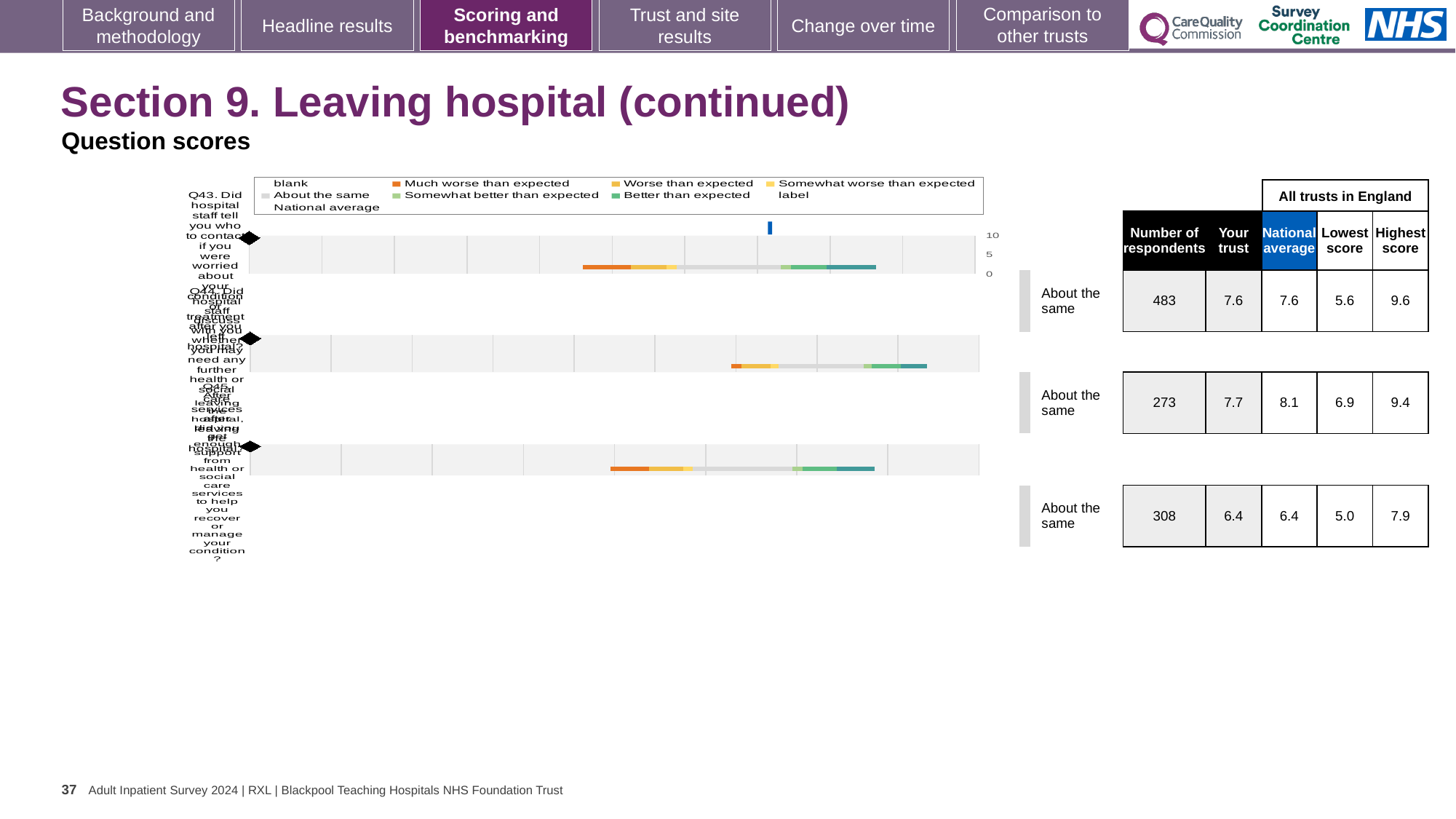
In the table, which row has the lowest 'Your trust' score? the third row (6.4) How many separate question-score charts are shown on the slide? 3 In the table, what is the highest score in the third row? 7.9 In the table, what is the number of respondents in the first row? 483 In the table, what is the difference between the national average and the 'Your trust' score in the second row? 0.4 In the table, is the number of respondents in the first row greater or less than 400? greater What is the highest tick value shown on the x axis of the top chart? 10 What kind of chart is used to show the question scores on this slide? bar chart In the table, what is the 'Your trust' score in the second row? 7.7 How many charts on the slide are labelled 'About the same'? 3